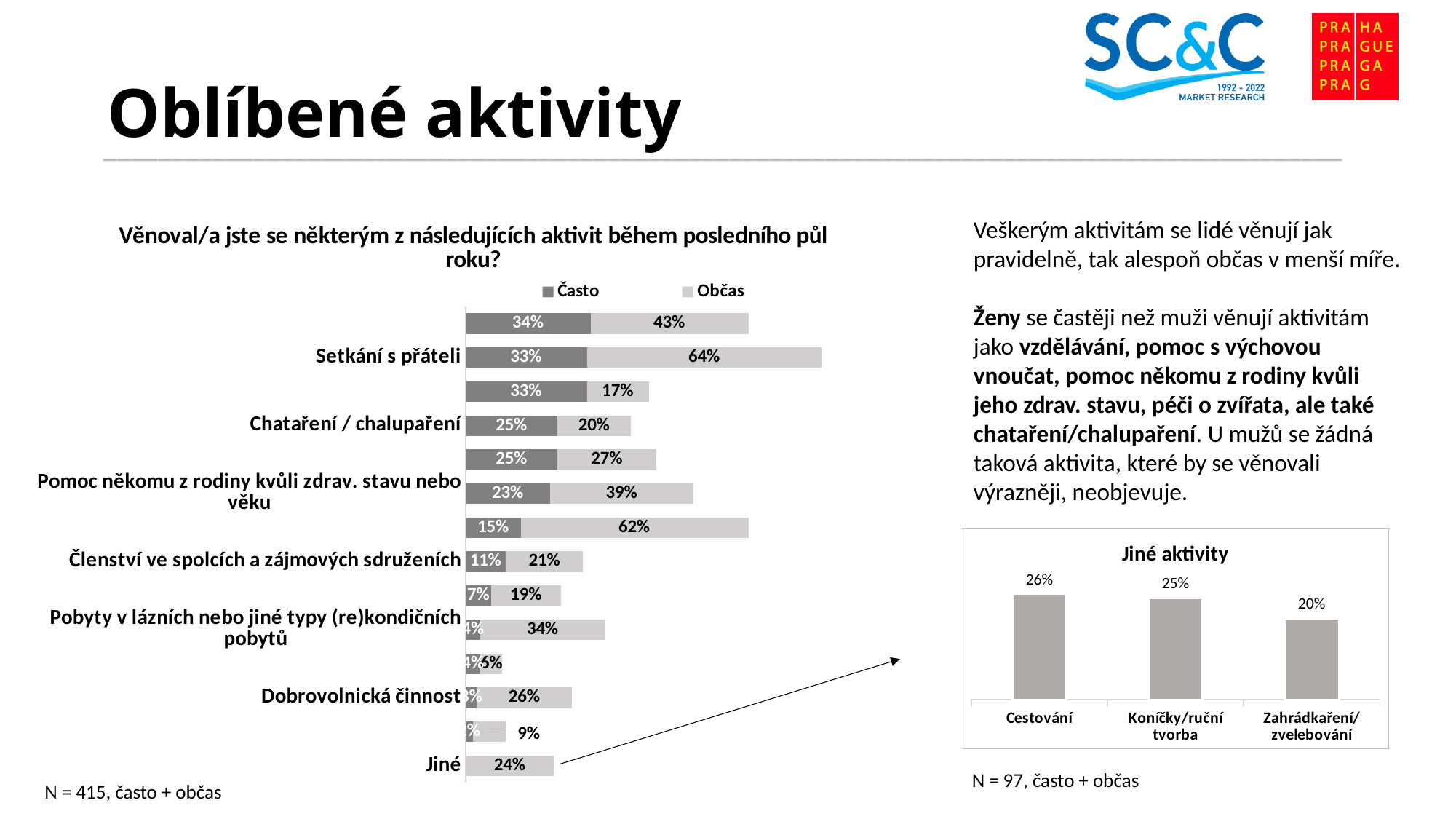
What kind of chart is the 'Jiné aktivity' chart? bar chart In the 'Jiné aktivity' chart, what is the value for Cestování? 26% In the 'Jiné aktivity' chart, what is the difference between Cestování and Zahrádkaření/zvelebování? 6% In the chart 'Věnoval/a jste se některým z následujících aktivit během posledního půl roku?', what is the Často value for Chataření / chalupaření? 25% In the 'Jiné aktivity' chart, which category has the lowest value? Zahrádkaření/zvelebování In the chart 'Věnoval/a jste se některým z následujících aktivit během posledního půl roku?', what is the total of Často and Občas for 'Pomoc někomu z rodiny kvůli zdrav. stavu nebo věku'? 62% In the chart 'Věnoval/a jste se některým z následujících aktivit během posledního půl roku?', what is the Občas value for Setkání s přáteli? 64% In the chart 'Věnoval/a jste se některým z následujících aktivit během posledního půl roku?', which has the larger Občas value: Setkání s přáteli or Pomoc někomu z rodiny kvůli zdrav. stavu nebo věku? Setkání s přáteli In the chart 'Věnoval/a jste se některým z následujících aktivit během posledního půl roku?', what value is shown for Jiné? 24% In the chart 'Věnoval/a jste se některým z následujících aktivit během posledního půl roku?', what is the Občas value for Dobrovolnická činnost? 26% How many series does the legend of the chart 'Věnoval/a jste se některým z následujících aktivit během posledního půl roku?' list? 2 How many categories are shown in the 'Jiné aktivity' chart? 3